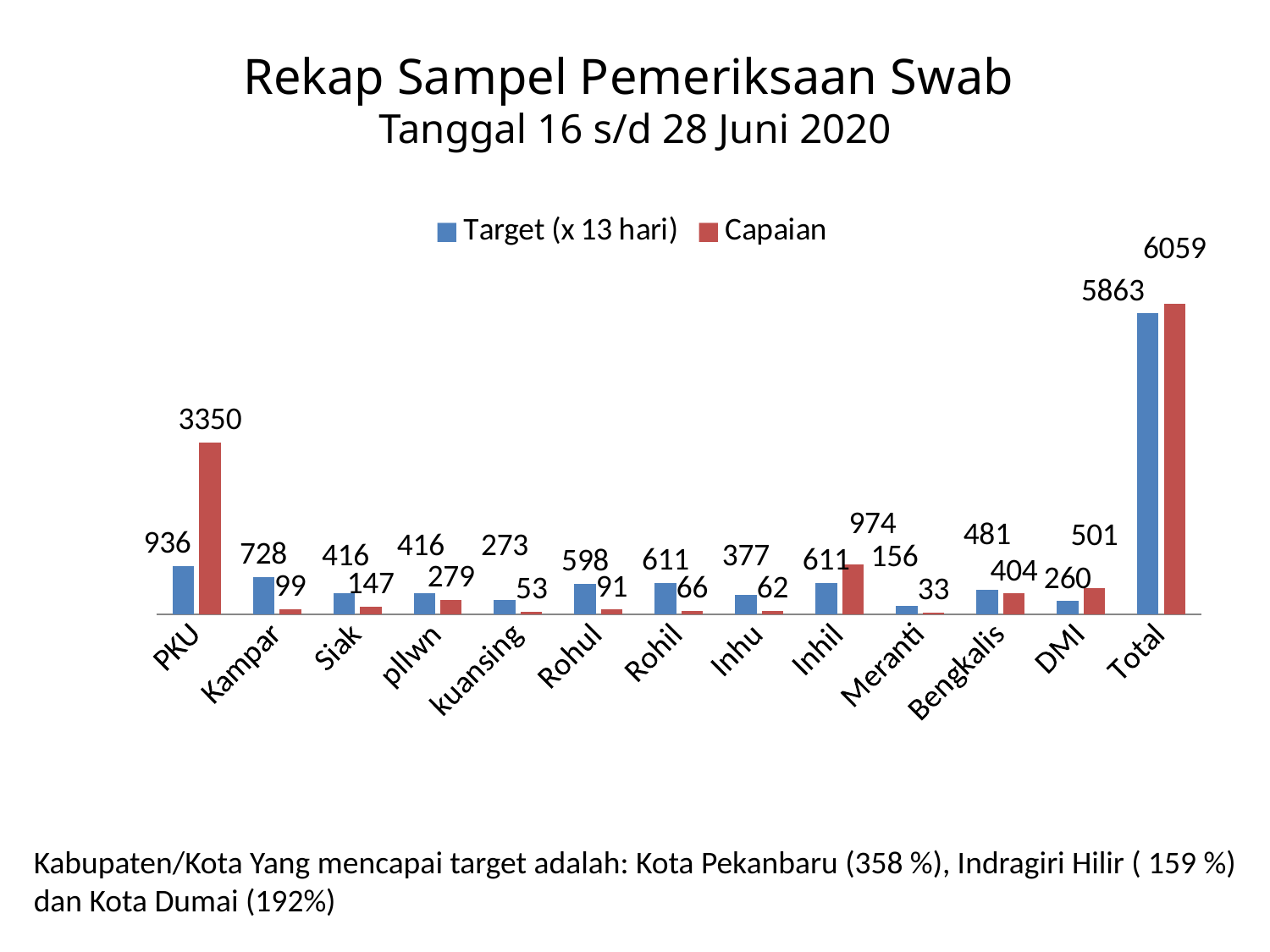
What kind of chart is shown on the slide? Bar chart How many categories are shown on the x axis? 13 What is the difference between the Capaian and Target (x 13 hari) values for Total? 196 Which category has the lowest Capaian value? Meranti Which colour represents the Capaian series in the chart? Red Excluding the Total bar, which category has the highest Capaian value? PKU What is the Target (x 13 hari) value for Kampar? 728 For Bengkalis, which is larger: the Target (x 13 hari) value or the Capaian value? Target (x 13 hari) How many series does the legend list? 2 What is the Capaian value for DMI? 501 What is the Capaian value for PKU? 3350 What is the difference between the Capaian and Target (x 13 hari) values for Inhil? 363